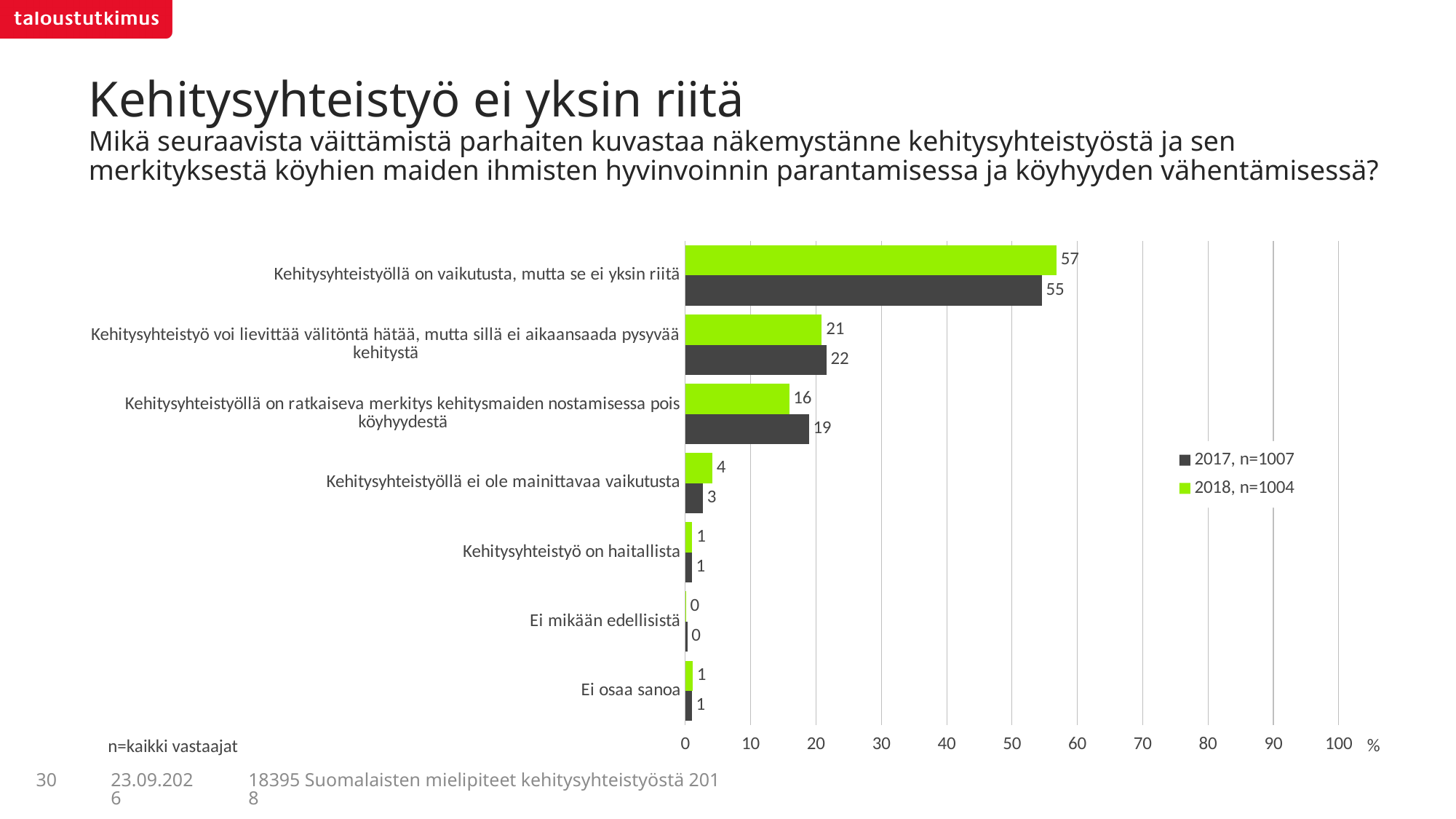
What is the 2018 value for "Kehitysyhteistyöllä ei ole mainittavaa vaikutusta"? 4 What is the 2018 value for "Kehitysyhteistyöllä on vaikutusta, mutta se ei yksin riitä"? 57 Which category has the lowest value in the 2017 series? Ei mikään edellisistä What is the 2017 value for "Kehitysyhteistyöllä on ratkaiseva merkitys kehitysmaiden nostamisessa pois köyhyydestä"? 19 Is the 2017 value for "Kehitysyhteistyöllä on vaikutusta, mutta se ei yksin riitä" greater or less than 50? greater What is the difference between the 2018 and 2017 values for "Kehitysyhteistyöllä on ratkaiseva merkitys kehitysmaiden nostamisessa pois köyhyydestä"? 3 How many categories are shown on the chart? 7 What is the 2017 value for "Kehitysyhteistyöllä on vaikutusta, mutta se ei yksin riitä"? 55 How many series does the legend list? 2 Which category has the highest value in the 2018 series? Kehitysyhteistyöllä on vaikutusta, mutta se ei yksin riitä What type of chart is shown on the slide? Bar chart For "Kehitysyhteistyö voi lievittää välitöntä hätää, mutta sillä ei aikaansaada pysyvää kehitystä", which year has the larger value, 2017 or 2018? 2017